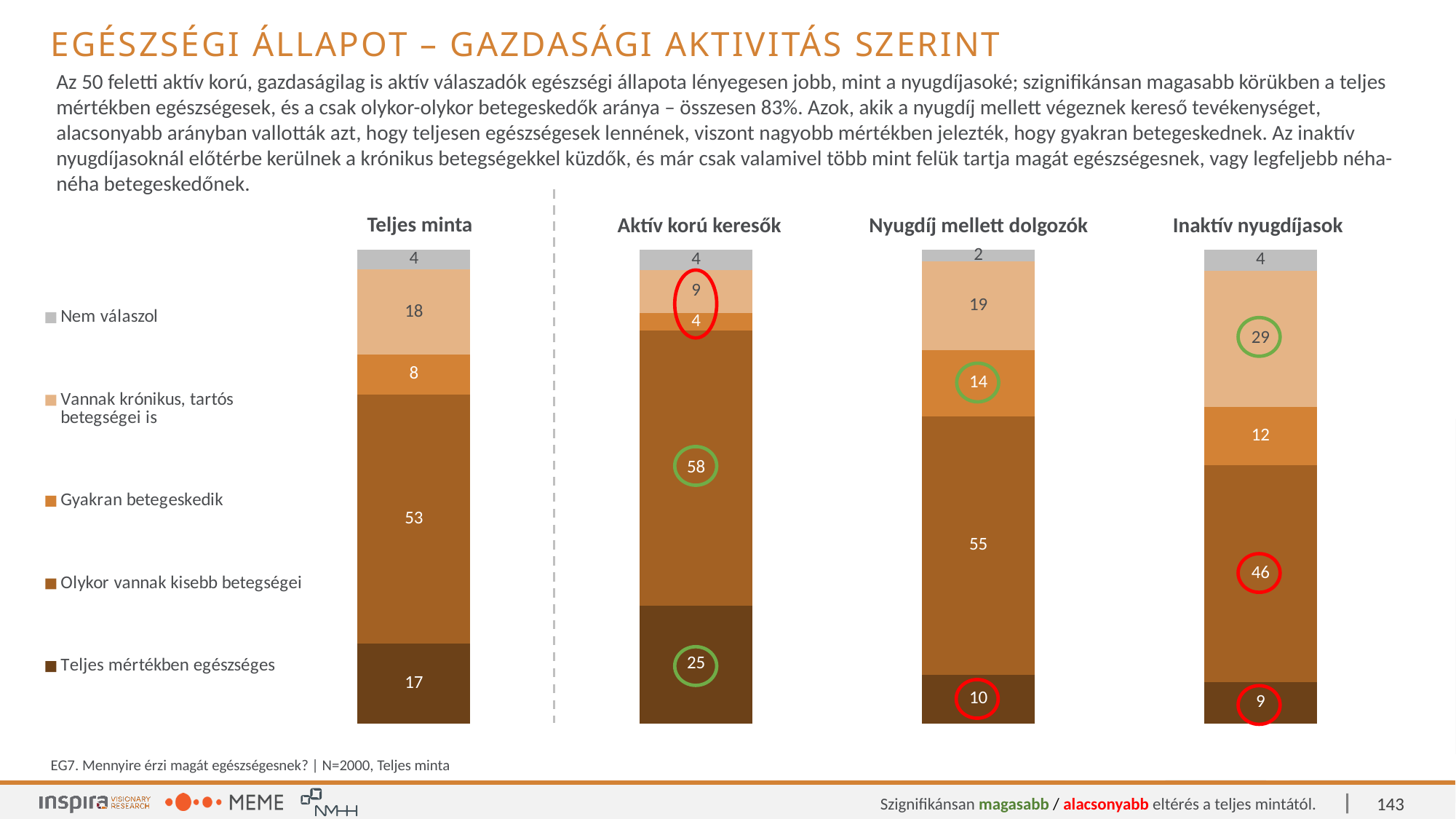
What kind of chart is shown on the slide? stacked bar chart How many series does the legend list? 5 How many bars (groups) are plotted on the chart? 4 What is the value for 'Vannak krónikus, tartós betegségei is' in the 'Inaktív nyugdíjasok' bar? 29 What is the value for 'Teljes mértékben egészséges' in the 'Aktív korú keresők' bar? 25 Which is larger: the 'Vannak krónikus, tartós betegségei is' value for 'Nyugdíj mellett dolgozók' or for 'Aktív korú keresők'? Nyugdíj mellett dolgozók What is the total of the 'Inaktív nyugdíjasok' stacked bar? 100 What is the value for 'Gyakran betegeskedik' in the 'Nyugdíj mellett dolgozók' bar? 14 Which bar has the highest value for 'Olykor vannak kisebb betegségei'? Aktív korú keresők Which bar has the lowest value for 'Teljes mértékben egészséges'? Inaktív nyugdíjasok What is the difference between the 'Teljes mértékben egészséges' values for 'Aktív korú keresők' and 'Teljes minta'? 8 What is the value for 'Olykor vannak kisebb betegségei' in the 'Teljes minta' bar? 53